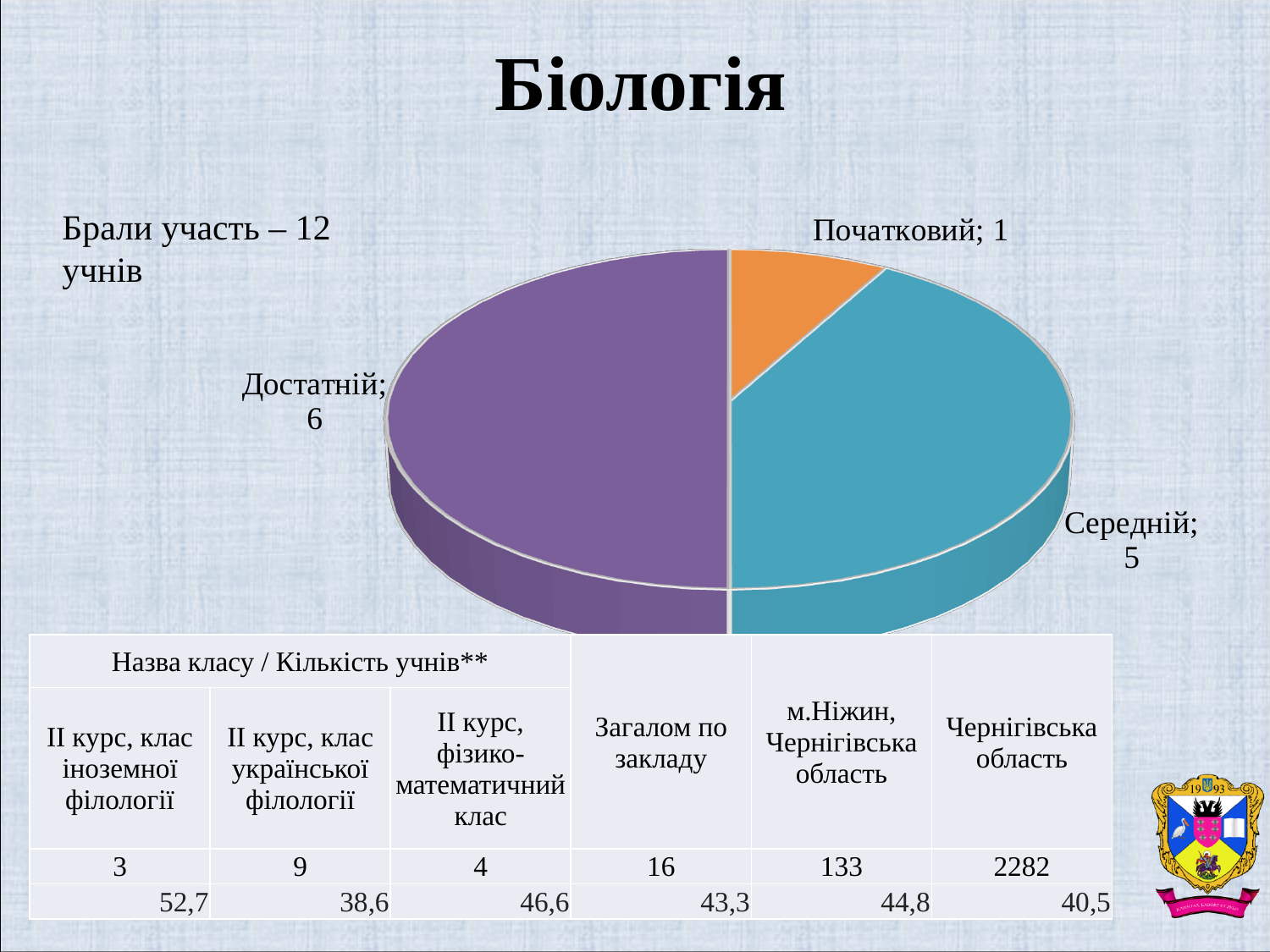
What is the title of the slide containing the pie chart? Біологія What share of the pie does the Достатній slice represent? 50% Which slice of the pie chart is the largest? Достатній What is the difference between the Достатній and Середній values? 1 Which is larger, the Середній value or the Початковий value? Середній What is the total of all slices in the pie chart? 12 What is the value for the Достатній slice? 6 Which slice of the pie chart is the smallest? Початковий What kind of chart is shown on the slide? pie chart What is the value for the Початковий slice? 1 What is the value for the Середній slice? 5 How many slices does the pie chart have? 3